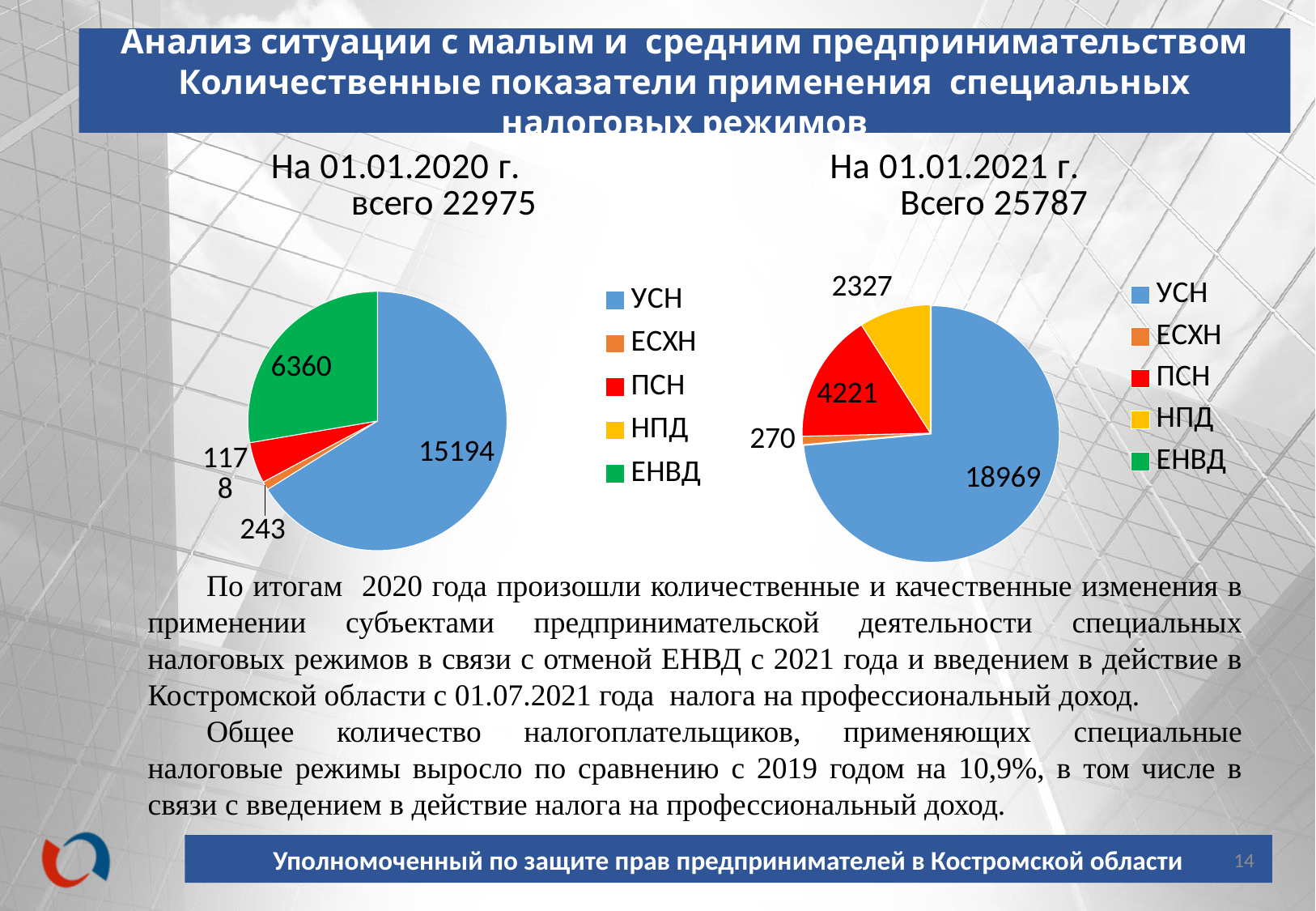
In the chart 'На 01.01.2020 г. всего 22975', what is the value for ЕНВД? 6360 How many entries does the legend of the chart 'На 01.01.2021 г. Всего 25787' list? 5 What kind of chart is the chart titled 'На 01.01.2020 г. всего 22975'? pie chart In the chart 'На 01.01.2021 г. Всего 25787', what is the difference between the values for УСН and ПСН? 14748 In the chart 'На 01.01.2021 г. Всего 25787', which category has the smallest slice? ЕСХН In the chart 'На 01.01.2020 г. всего 22975', which category has the largest slice? УСН In the chart 'На 01.01.2021 г. Всего 25787', what is the value for УСН? 18969 In the chart 'На 01.01.2020 г. всего 22975', what is the difference between the values for ЕНВД and ЕСХН? 6117 In the chart 'На 01.01.2021 г. Всего 25787', what is the value for НПД? 2327 In the chart 'На 01.01.2021 г. Всего 25787', what is the value for ПСН? 4221 In the chart 'На 01.01.2020 г. всего 22975', what is the value for УСН? 15194 In the chart 'На 01.01.2020 г. всего 22975', what is the value for ЕСХН? 243